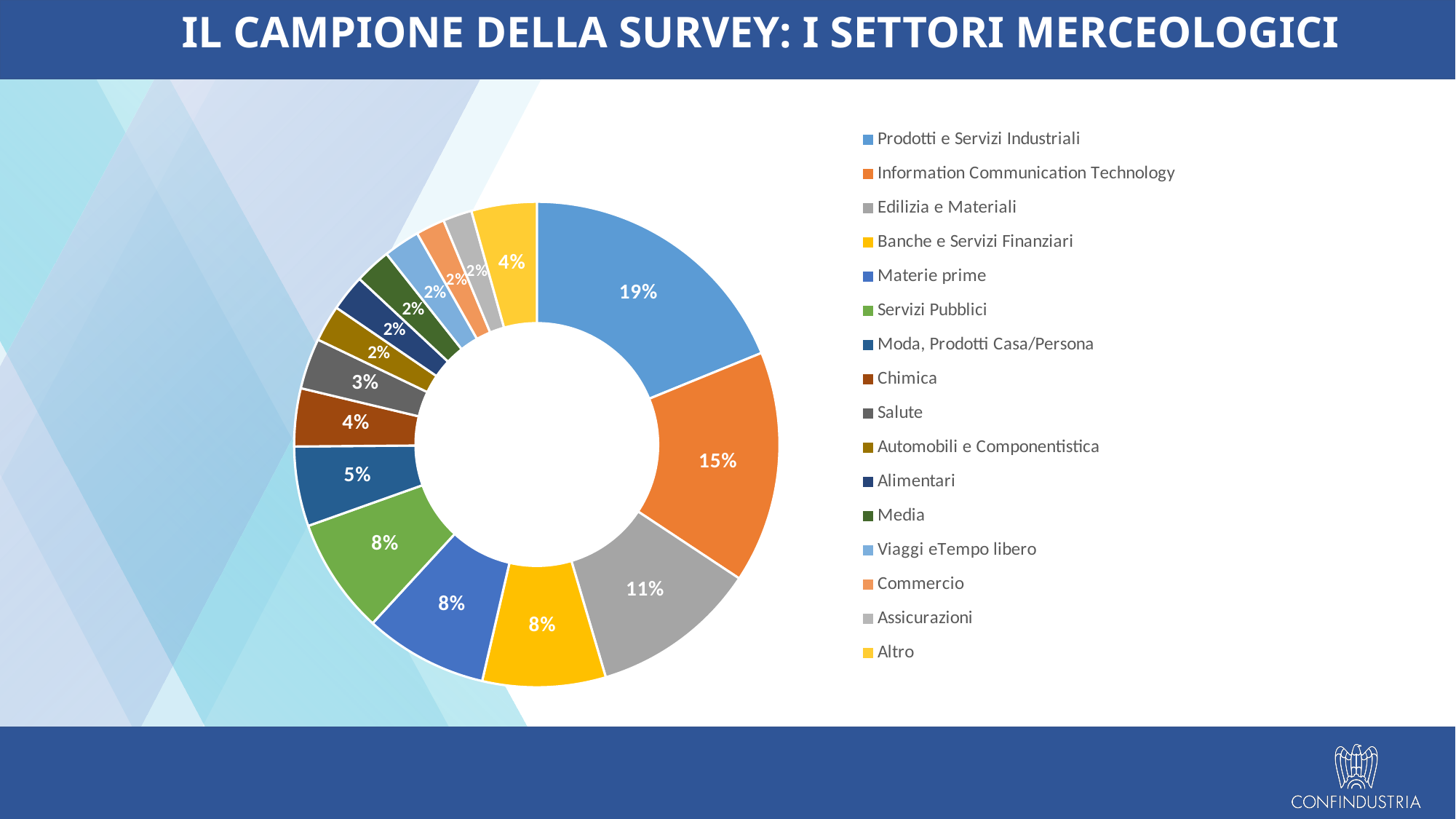
What is the title of the slide? IL CAMPIONE DELLA SURVEY: I SETTORI MERCEOLOGICI What share of the survey sample is Prodotti e Servizi Industriali? 19% What is the value for Chimica? 4% Which is larger, the share for Edilizia e Materiali or the share for Servizi Pubblici? Edilizia e Materiali What is the difference between the shares of Prodotti e Servizi Industriali and Information Communication Technology? 4% What percentage does Information Communication Technology represent? 15% Which sector has the largest share of the sample? Prodotti e Servizi Industriali What is the value shown for Edilizia e Materiali? 11% What share does Salute have? 3% How many sectors are listed in the legend? 16 What percentage is shown for Moda, Prodotti Casa/Persona? 5% What kind of chart is shown on the slide? Doughnut (pie) chart